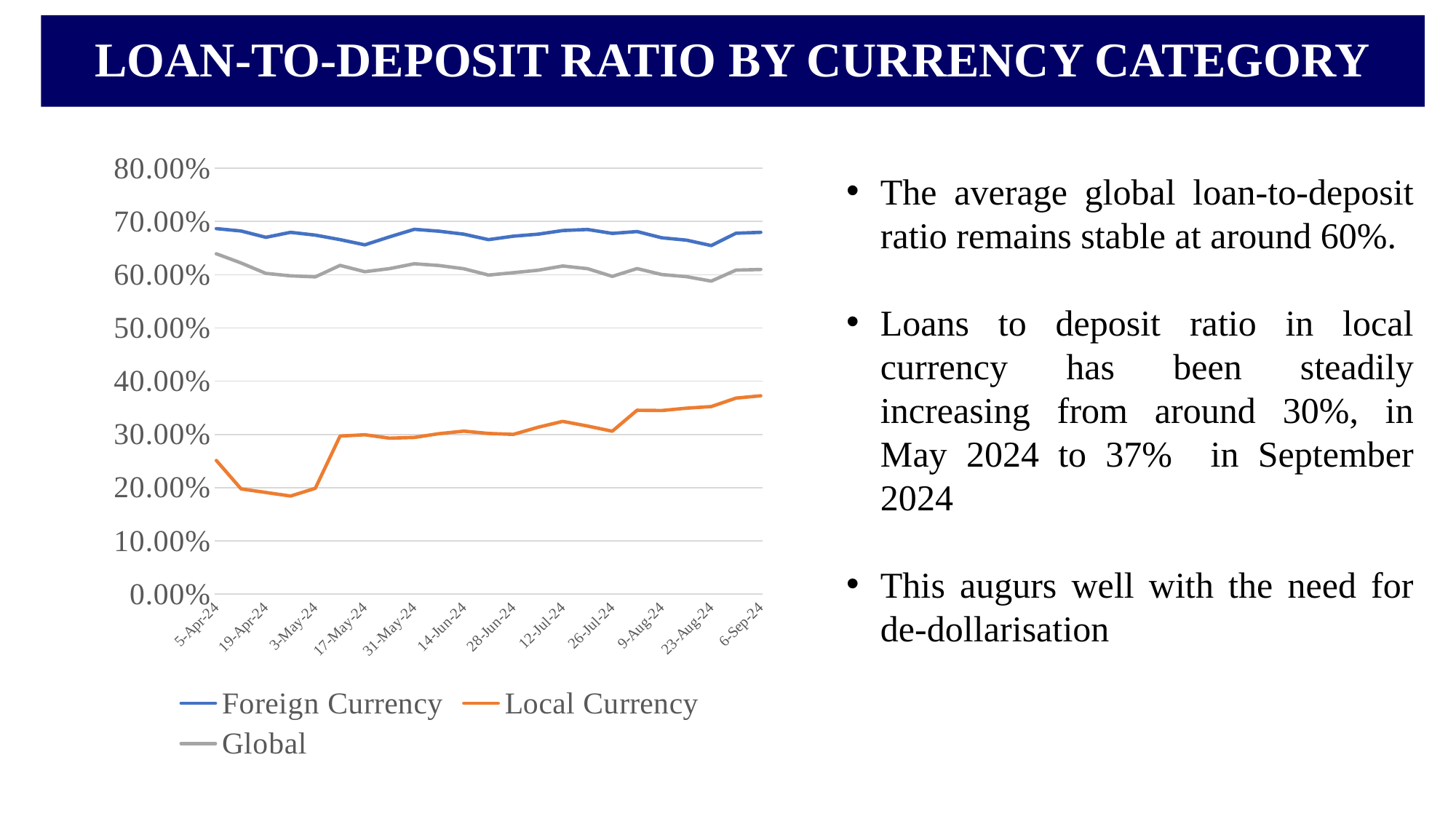
Which series has the lowest values across the whole period shown? Local Currency How many series does the chart legend list? 3 Is the Local Currency value at 6-Sep-24 greater or less than 30.00%? greater Which series is plotted with the orange line? Local Currency What kind of chart is shown on the slide? line chart Is the Global value at 5-Apr-24 greater or less than 60.00%? greater Is the Foreign Currency value at 5-Apr-24 greater or less than 60.00%? greater At 6-Sep-24, which is larger: the Foreign Currency value or the Local Currency value? Foreign Currency Which series has the highest values across the whole period shown? Foreign Currency Does the Local Currency series rise or fall from 17-May-24 to 6-Sep-24? rise